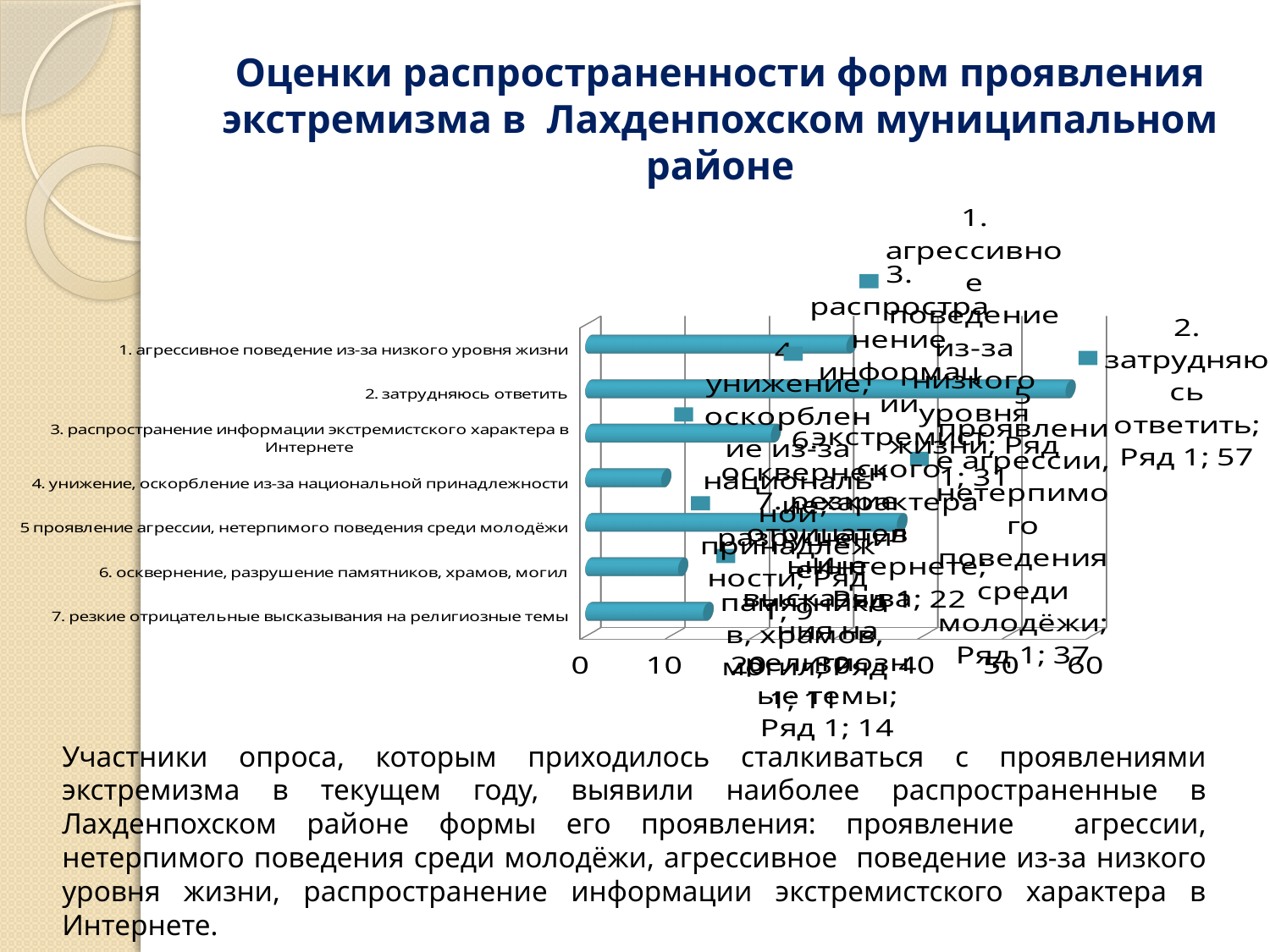
What is the difference between the values for "2. затрудняюсь ответить" and "5 проявление агрессии, нетерпимого поведения среди молодёжи"? 20 Is the value for "3. распространение информации экстремистского характера в Интернете" greater or less than 30? less What is the value for "1. агрессивное поведение из-за низкого уровня жизни"? 31 What kind of chart is shown on the slide? bar chart Which category has the highest value in the chart? 2. затрудняюсь ответить Is the value for "4. унижение, оскорбление из-за национальной принадлежности" greater or less than 20? less How many categories does the chart show? 7 What is the value for "5 проявление агрессии, нетерпимого поведения среди молодёжи"? 37 Which is larger: the value for "5 проявление агрессии, нетерпимого поведения среди молодёжи" or the value for "1. агрессивное поведение из-за низкого уровня жизни"? 5 проявление агрессии, нетерпимого поведения среди молодёжи Is the value for "7. резкие отрицательные высказывания на религиозные темы" greater or less than 20? less What is the value for "2. затрудняюсь ответить"? 57 What is the difference between the values for "5 проявление агрессии, нетерпимого поведения среди молодёжи" and "1. агрессивное поведение из-за низкого уровня жизни"? 6